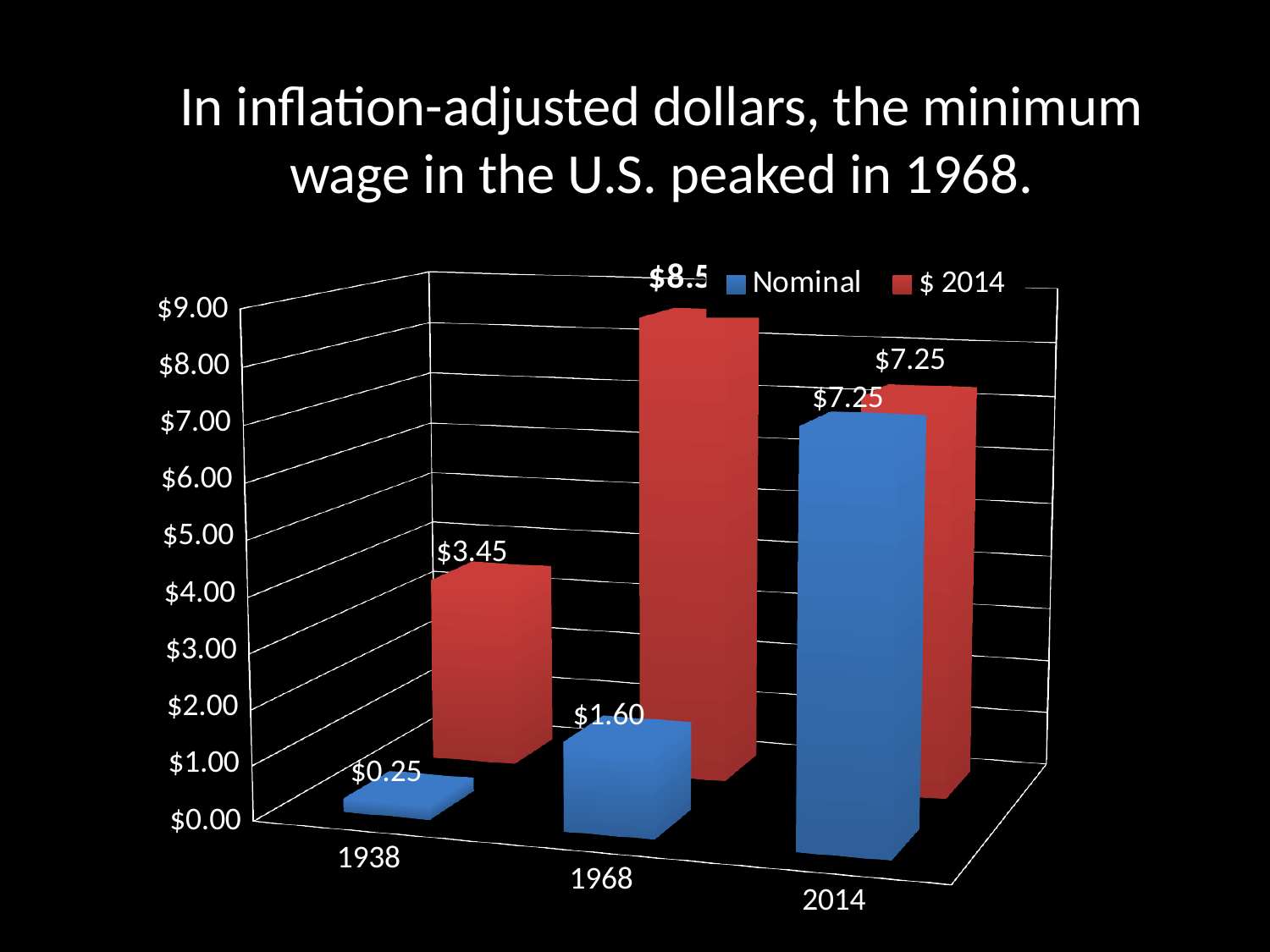
Which year has the highest $ 2014 (inflation-adjusted) value? 1968 What is the Nominal minimum wage value shown for 1938? $0.25 How many series does the legend list? 2 Is the $ 2014 value for 1968 greater or less than $8.00? greater How many years are shown on the x axis? 3 What is the $ 2014 value shown for 2014? $7.25 Which year has the lowest Nominal value? 1938 What is the difference between the Nominal values for 2014 and 1968? $5.65 Which is larger: the Nominal value for 1968 or the $ 2014 value for 1938? $ 2014 value for 1938 What is the Nominal value shown for 1968? $1.60 Do the Nominal values rise or fall from 1938 to 2014? rise What is the $ 2014 value shown for 1938? $3.45